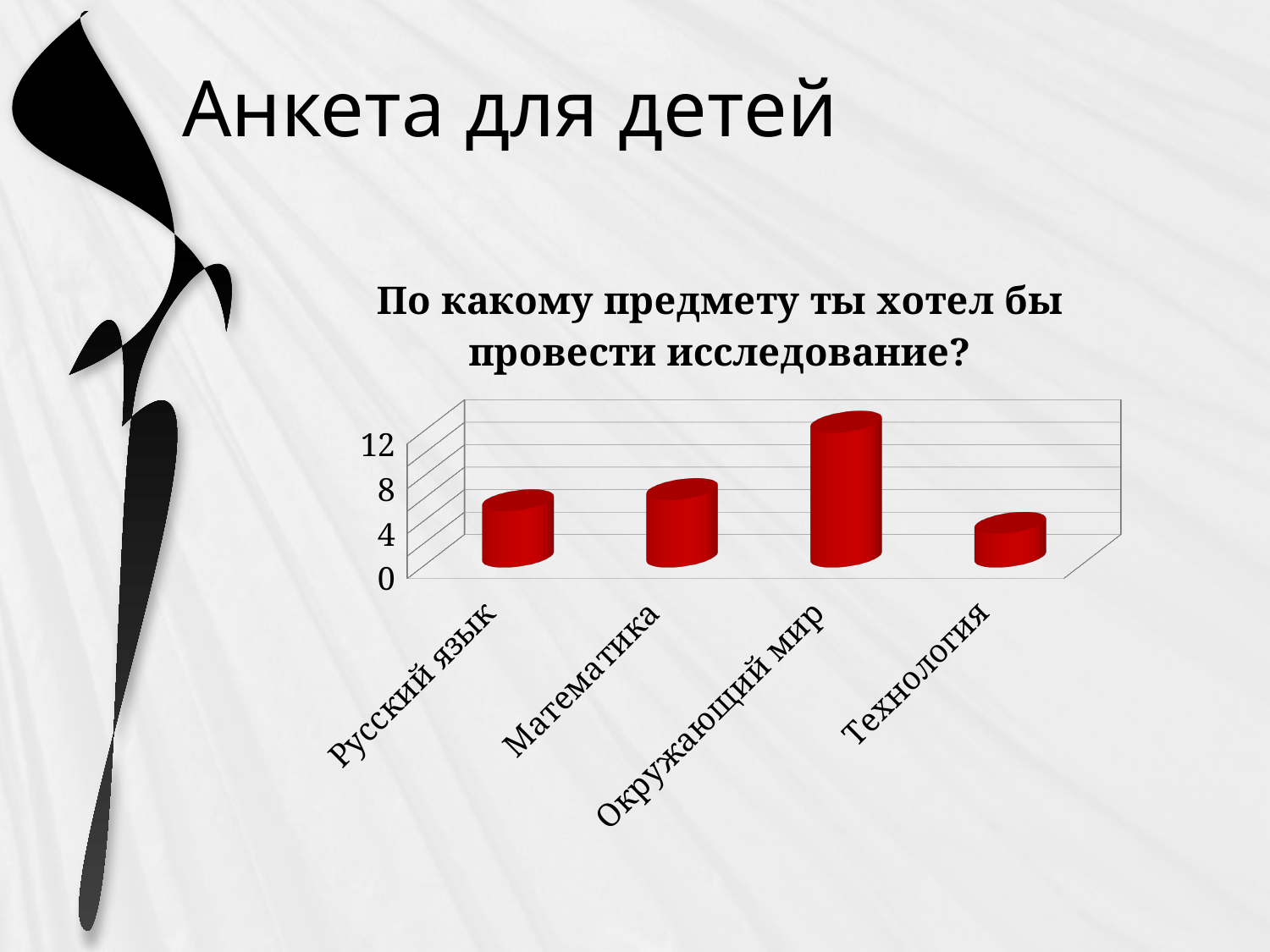
What colour are the bars in the chart? red What is the title of the chart? По какому предмету ты хотел бы провести исследование? Which subject has the highest value on the chart? Окружающий мир Is the value for Окружающий мир greater or less than 8? greater How many categories (subjects) are shown on the chart? 4 Which subject has the lowest value on the chart? Технология Is the value for Технология greater or less than 8? less Is the value for Математика greater or less than 8? less What kind of chart is shown on the slide? bar chart Which has a larger value: Окружающий мир or Математика? Окружающий мир Which has a larger value: Русский язык or Технология? Русский язык What is the highest value labelled on the vertical axis of the chart? 12